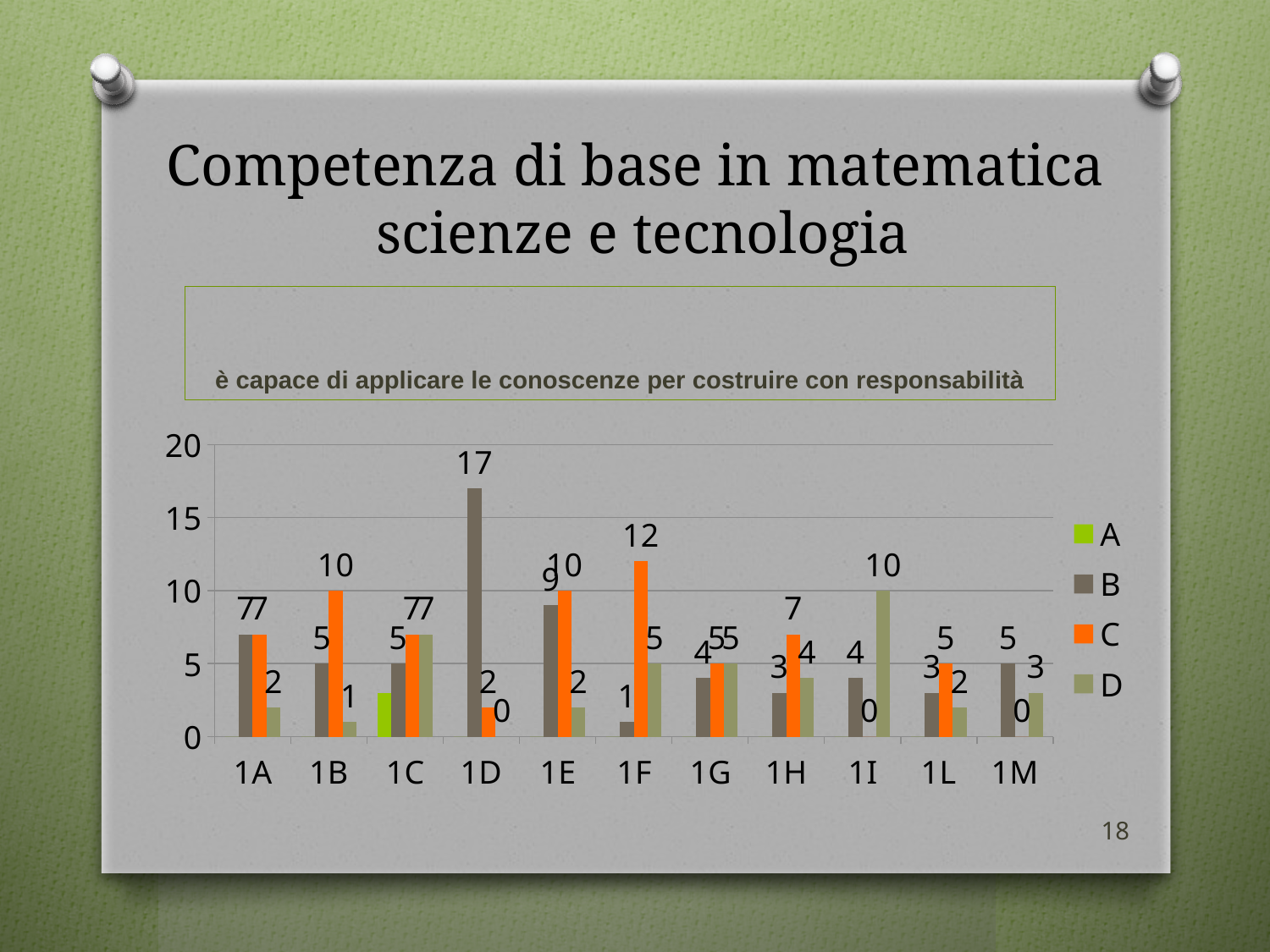
What is the value of series C for category 1F? 12 What is the difference between series B and series C for category 1D? 15 How many series does the legend list? 4 How many categories are shown on the x axis? 11 Which category has the lowest value for series D? 1D Is the value of series A for category 1C greater or less than 5? less For category 1B, which is larger: series B or series C? C What is the value of series C for category 1I? 0 Which category has the highest value for series B? 1D What is the value of series D for category 1I? 10 What kind of chart is shown on the slide? bar chart What is the value of series B for category 1D? 17